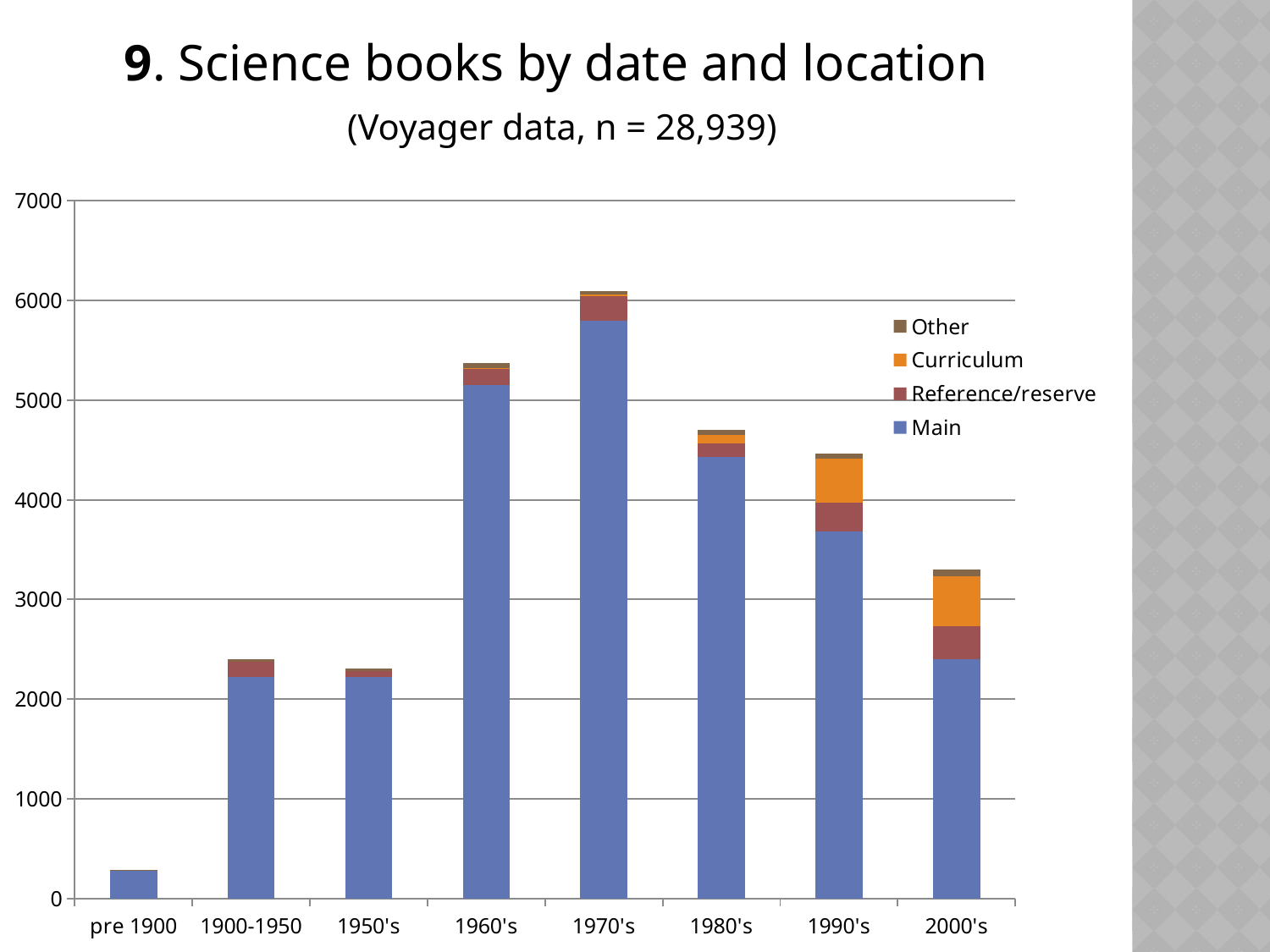
Do the total stacked values rise or fall from 1970's to 2000's? fall Is the Main value for 2000's greater or less than 3000? less Which series is shown in orange in the legend? Curriculum How many date categories are shown on the x axis? 8 What kind of chart is shown on the slide? Stacked bar chart Which has the larger total stacked bar, 1960's or 1980's? 1960's Which date category has the tallest stacked bar? 1970's How many series does the legend list? 4 Is the total stacked value for 1990's greater or less than 5000? less Is the total stacked value for 1960's greater or less than 5000? greater Which date category has the shortest stacked bar? pre 1900